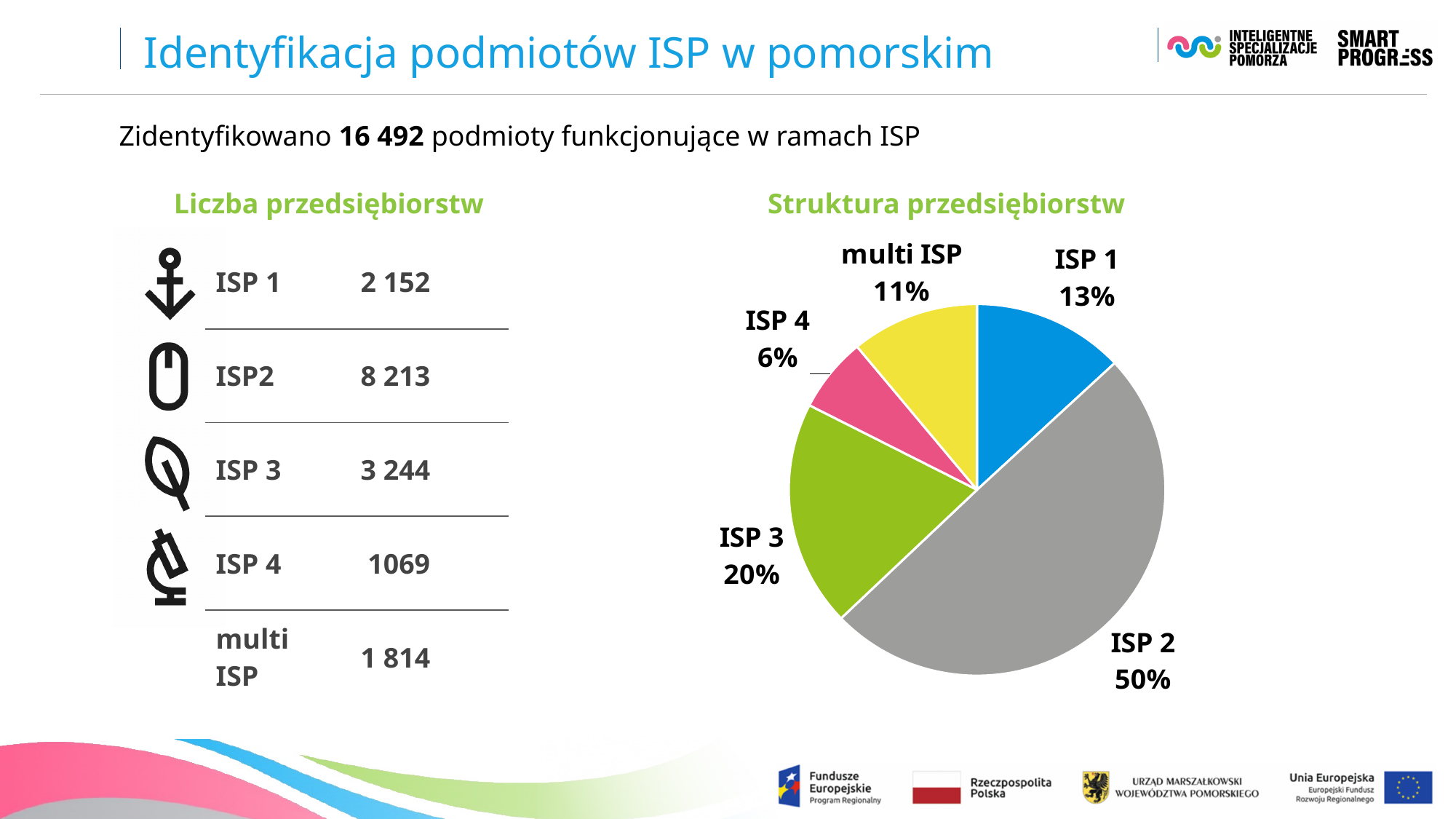
What is the difference in percentage points between ISP 3 and ISP 1 in the pie chart? 7 What percentage is shown for multi ISP in the pie chart? 11% What share of the pie chart does ISP 2 represent? 50% What percentage is shown for ISP 1 in the pie chart? 13% Which category has the smallest slice in the pie chart? ISP 4 How many slices does the pie chart have? 5 What is the title of the pie chart? Struktura przedsiębiorstw What colour is the ISP 2 slice in the pie chart? grey What type of chart is shown on the slide? pie chart Which category has the largest slice in the pie chart? ISP 2 Which is larger in the pie chart, ISP 3 or multi ISP? ISP 3 What percentage is shown for ISP 4 in the pie chart? 6%